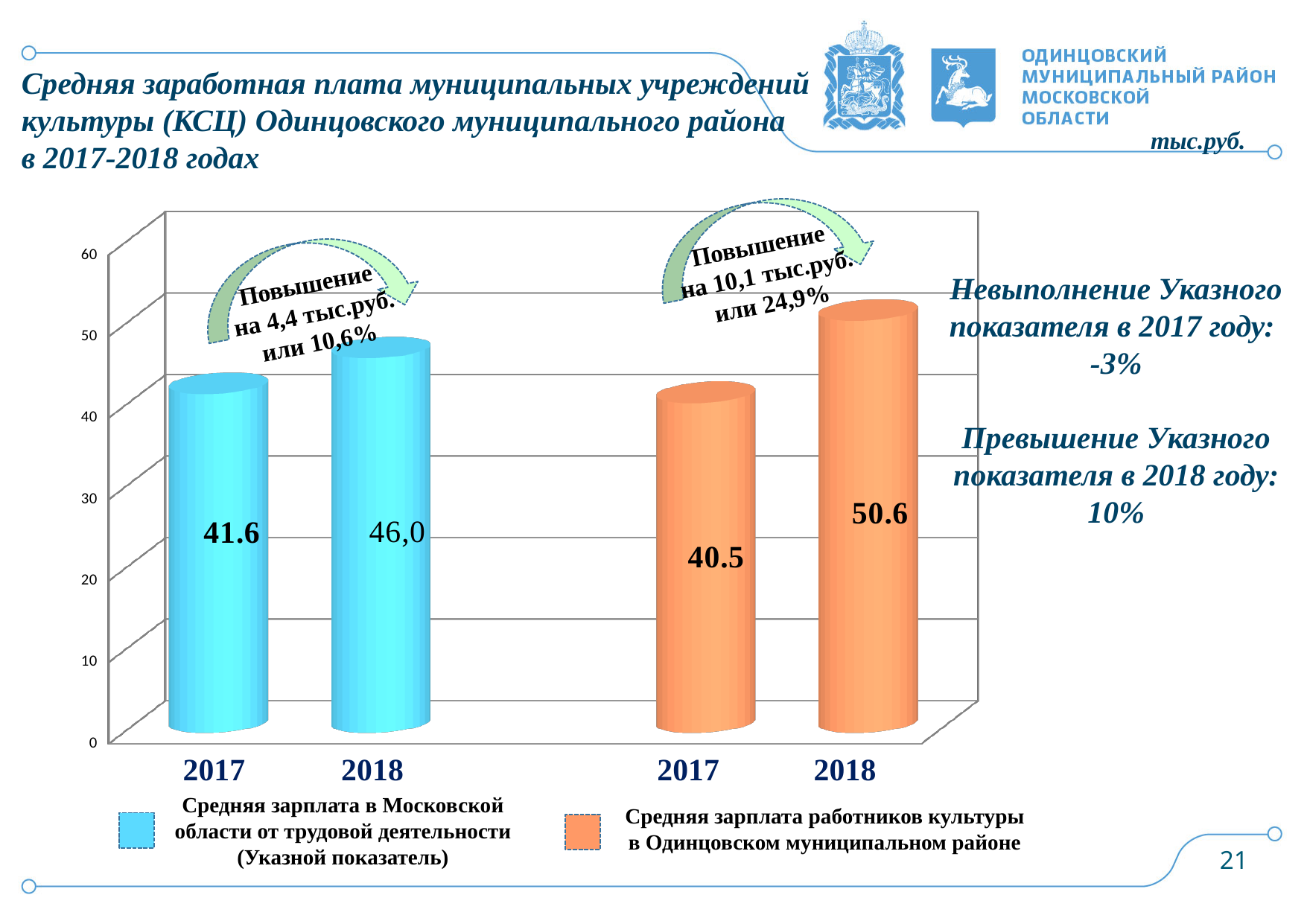
How many bars are plotted on the chart? 4 By how much did the average salary of culture workers in Odintsovo district (orange bars) increase from 2017 to 2018? 10.1 What is the value of the orange bar for 2017 (Средняя зарплата работников культуры в Одинцовском муниципальном районе)? 40.5 How many series does the legend list? 2 What is the value of the blue bar for 2018 (Указной показатель)? 46,0 Do the orange bars rise or fall from 2017 to 2018? Rise What is the value of the blue bar for 2017 (Средняя зарплата в Московской области от трудовой деятельности)? 41.6 Which bar has the highest value on the chart? 2018, Средняя зарплата работников культуры в Одинцовском муниципальном районе (50.6) What kind of chart is shown on the slide? Bar chart In 2018, which is larger: the Указной показатель (blue) or the salary of culture workers in Odintsovo district (orange)? Salary of culture workers in Odintsovo district (orange), 50.6 What is the value of the orange bar for 2018 (Средняя зарплата работников культуры в Одинцовском муниципальном районе)? 50.6 Which bar has the lowest value on the chart? 2017, Средняя зарплата работников культуры в Одинцовском муниципальном районе (40.5)